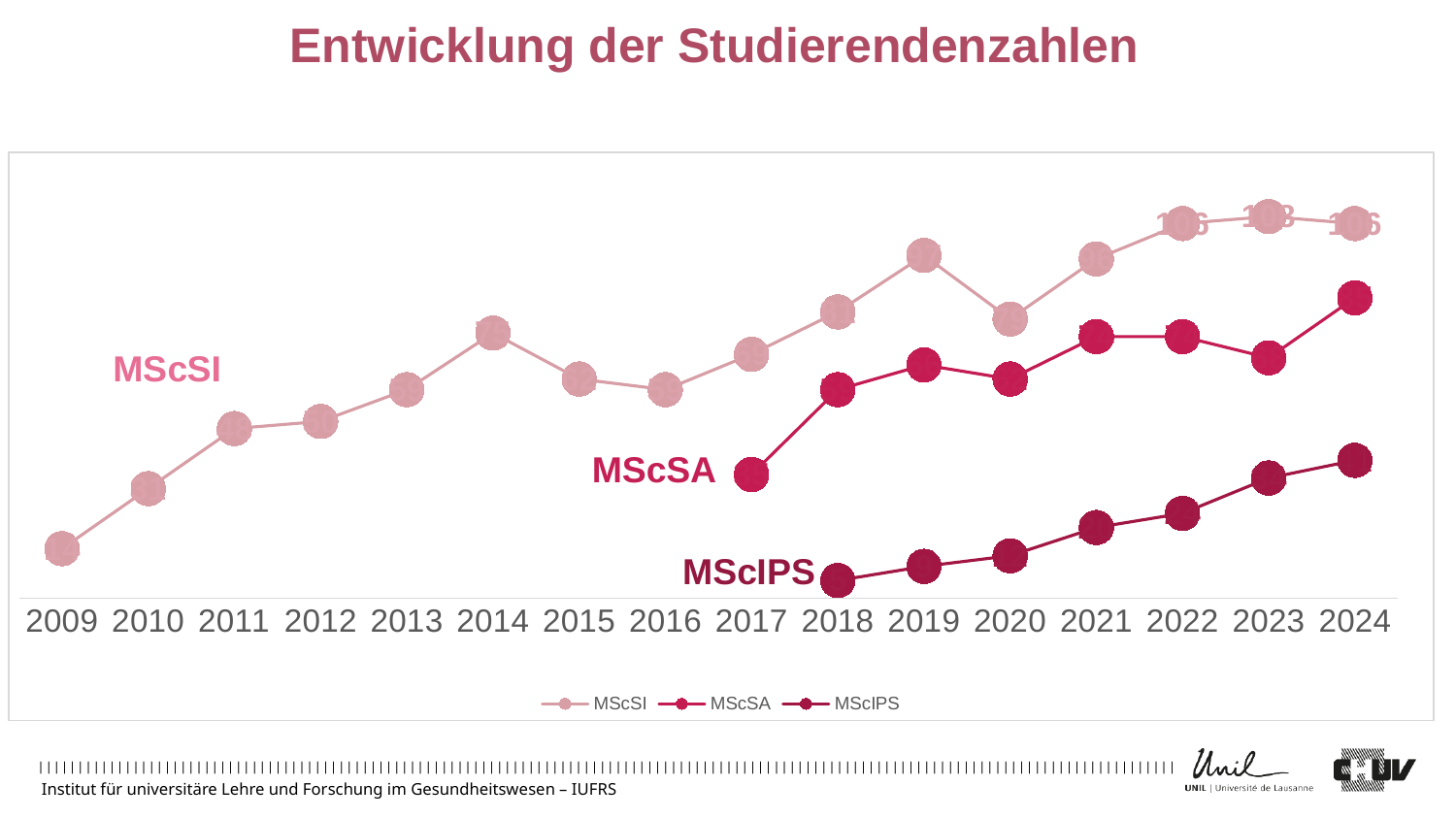
Which series has the highest value in 2024? MScSI How many years are shown on the x axis? 16 What kind of chart is shown on the slide? Line chart What is the title of the chart? Entwicklung der Studierendenzahlen Do the MScIPS values rise or fall from 2018 to 2024? Rise Which series has the lowest value in 2024? MScIPS In which year is the MScSI value lowest? 2009 In which year is the MScIPS value highest? 2024 In which year does the MScSA series first appear? 2017 How many series does the legend list? 3 Which is larger in 2018, MScSA or MScIPS? MScSA Which is larger for MScSI, the value in 2019 or the value in 2020? 2019